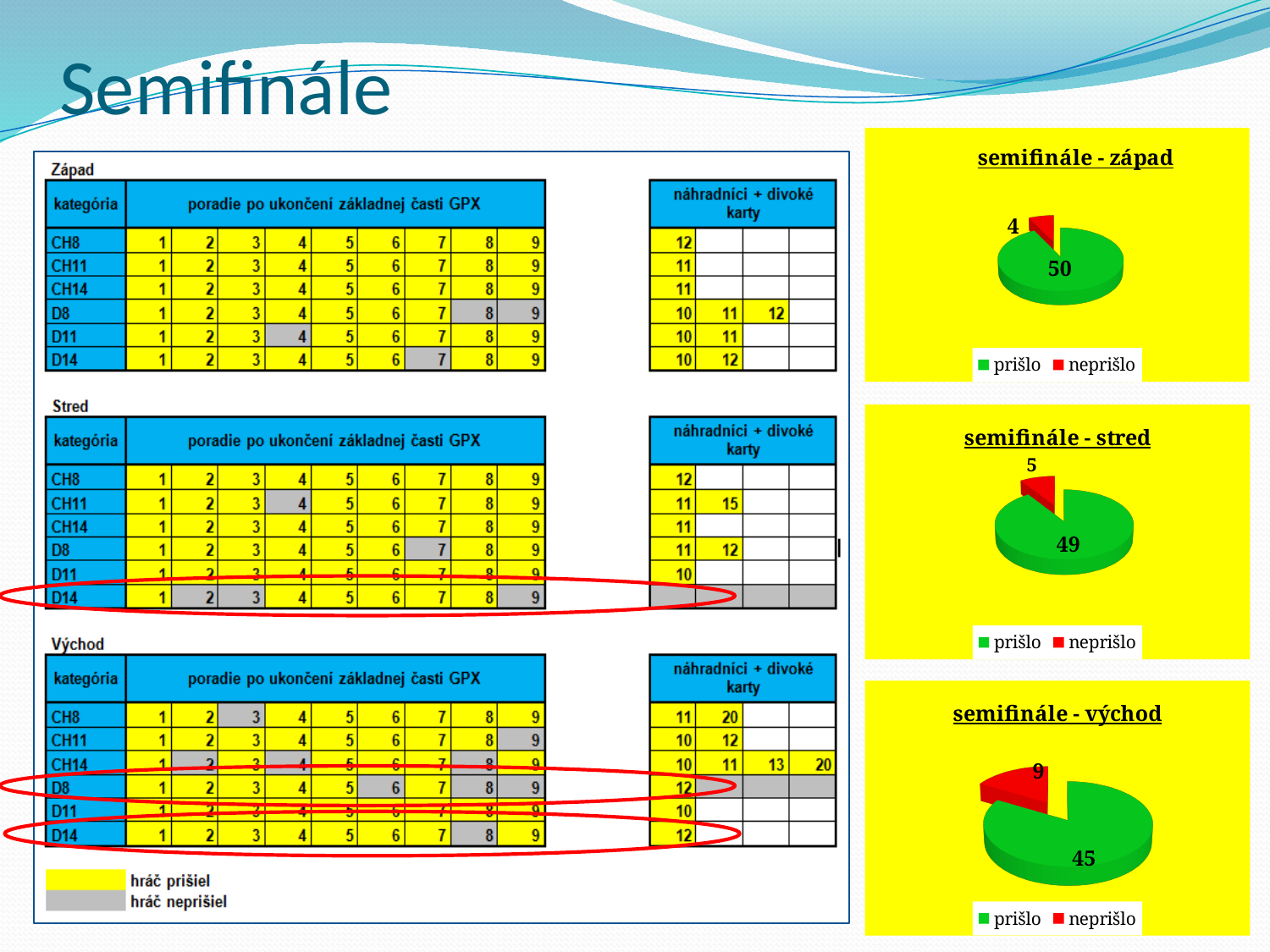
In the 'semifinále - západ' chart, what is the difference between prišlo and neprišlo? 46 In the 'semifinále - stred' chart, what is the difference between prišlo and neprišlo? 44 In the 'semifinále - západ' chart, what is the value for prišlo? 50 Which is larger: neprišlo in the 'semifinále - východ' chart or neprišlo in the 'semifinále - západ' chart? semifinále - východ In the 'semifinále - západ' chart, what is the value for neprišlo? 4 In the 'semifinále - stred' chart, what is the value for neprišlo? 5 In the 'semifinále - východ' chart, what is the value for neprišlo? 9 How many series does the legend of the 'semifinále - stred' chart list? 2 What type of chart is 'semifinále - západ'? pie chart In the 'semifinále - východ' chart, which slice is the smallest? neprišlo In the 'semifinále - východ' chart, what is the value for prišlo? 45 In the 'semifinále - stred' chart, which slice is the largest? prišlo